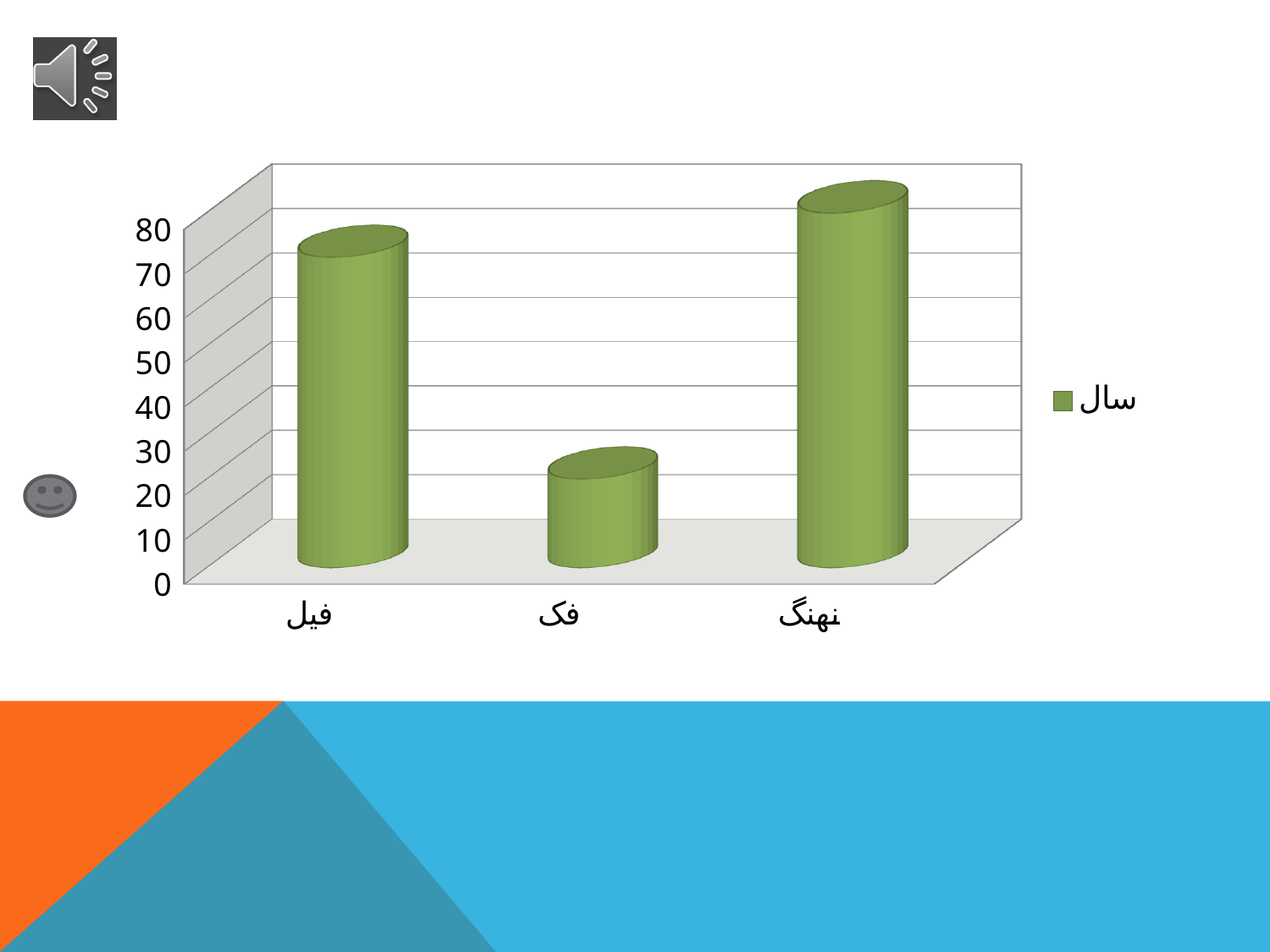
Is the value for نهنگ greater or less than 60? greater How many series does the chart's legend list? 1 Which category has the highest bar in the chart? نهنگ Is the value for فیل greater or less than 50? greater Is the value for فک greater or less than 40? less Which is larger, the value for فیل or the value for فک? فیل What colour are the bars in the chart? green What kind of chart is shown on the slide? bar chart Which is larger, the value for نهنگ or the value for فک? نهنگ What is the name of the series shown in the chart's legend? سال How many categories are shown on the x axis of the chart? 3 Which category has the lowest bar in the chart? فک